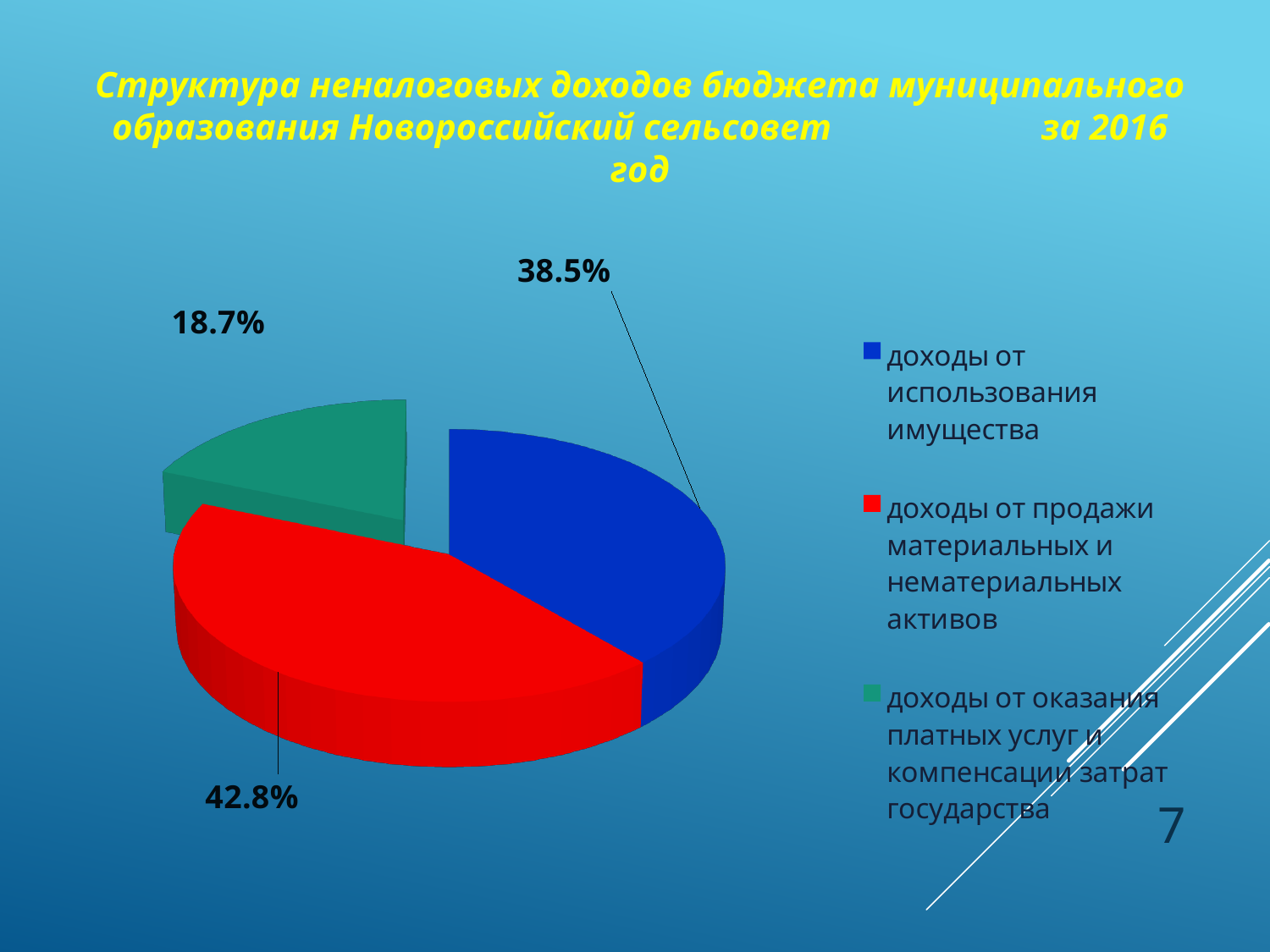
What colour is the slice for доходы от продажи материальных и нематериальных активов? red Which is larger: the share for доходы от использования имущества or the share for доходы от оказания платных услуг и компенсации затрат государства? доходы от использования имущества What share of non-tax revenues comes from доходы от оказания платных услуг и компенсации затрат государства? 18.7% Which category has the smallest share of the pie? доходы от оказания платных услуг и компенсации затрат государства Which category has the largest share of the pie? доходы от продажи материальных и нематериальных активов How many entries does the legend list? 3 What kind of chart is shown on the slide? pie chart What is the difference in percentage points between the share for доходы от использования имущества and the share for доходы от оказания платных услуг и компенсации затрат государства? 19.8 What share of non-tax revenues comes from доходы от использования имущества? 38.5% How many slices does the pie chart have? 3 What share of non-tax revenues comes from доходы от продажи материальных и нематериальных активов? 42.8% What is the difference in percentage points between the share for доходы от продажи материальных и нематериальных активов and the share for доходы от использования имущества? 4.3